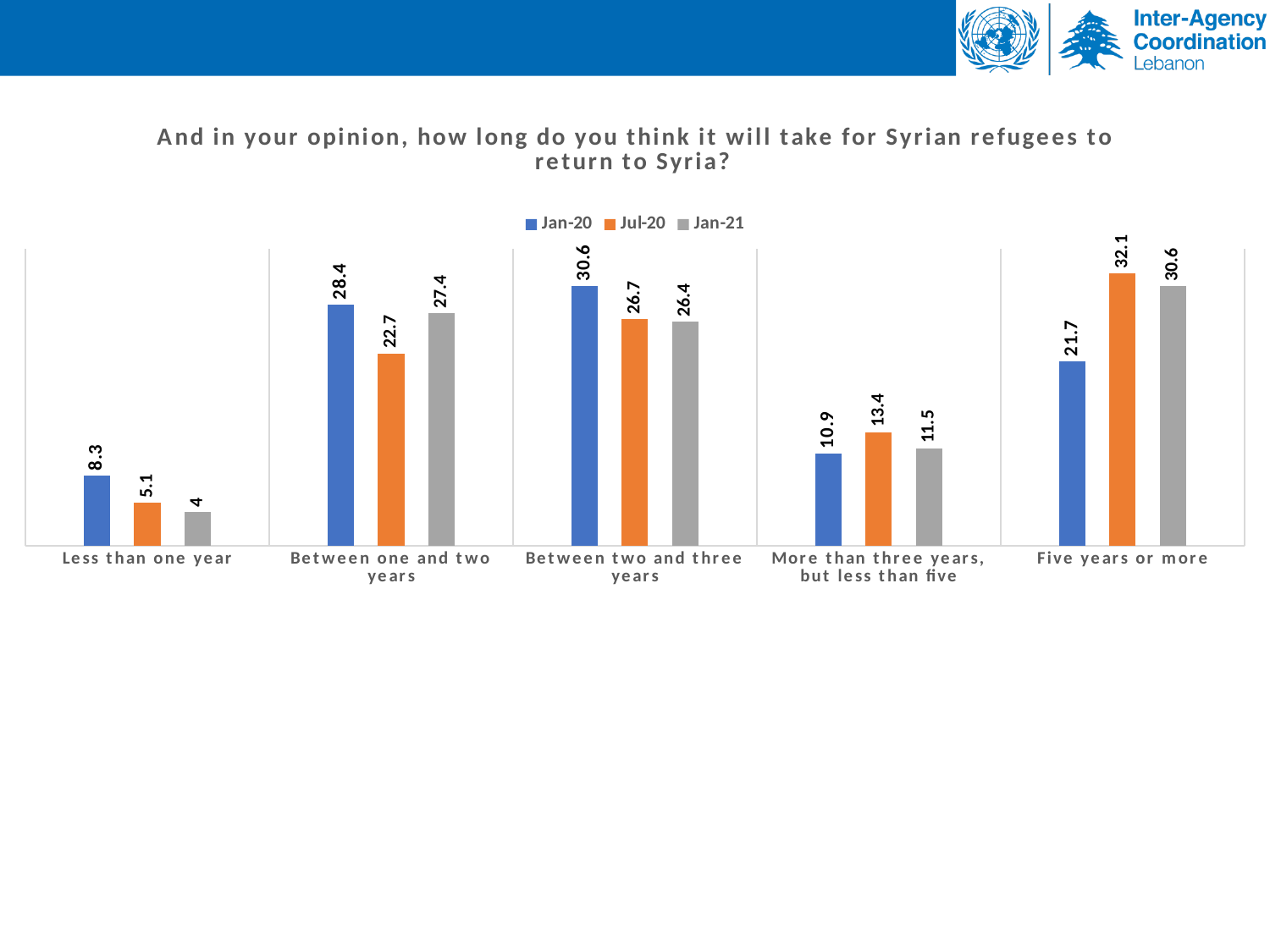
What is the Jul-20 value for 'Five years or more'? 32.1 How many series does the legend list? 3 Which series is shown in orange in the legend? Jul-20 What kind of chart is shown on the slide? Bar chart Which is larger for 'More than three years, but less than five': the Jul-20 value or the Jan-21 value? Jul-20 What is the Jan-20 value for 'Less than one year'? 8.3 How many categories are shown on the x axis? 5 Which category has the lowest Jan-21 value? Less than one year What is the difference between the Jul-20 and Jan-21 values for 'Five years or more'? 1.5 What is the Jan-21 value for 'Between one and two years'? 27.4 What is the difference between the Jan-20 and Jul-20 values for 'Between one and two years'? 5.7 Which category has the highest Jan-20 value? Between two and three years